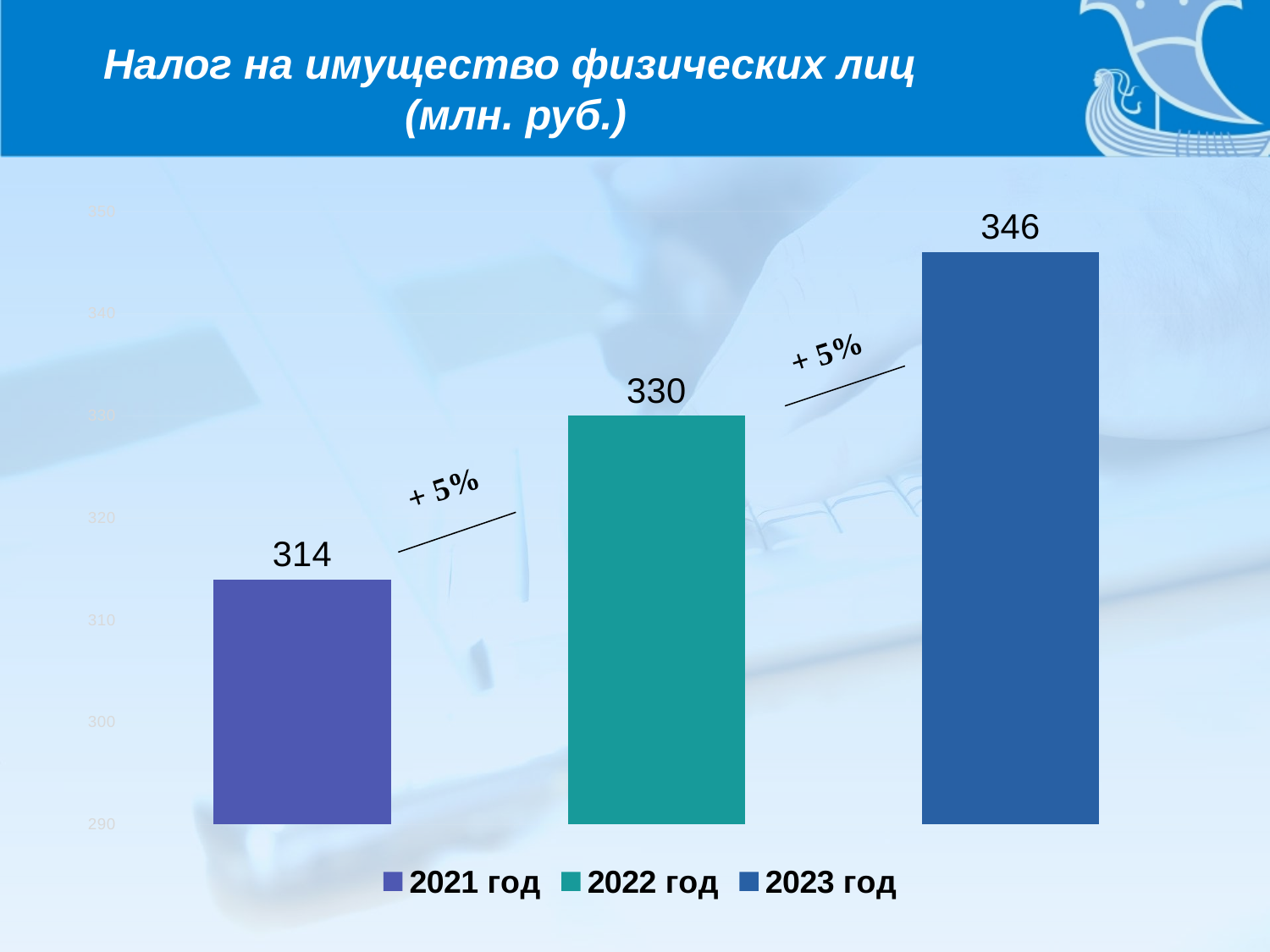
Which year has the lowest value? 2021 год Which is larger, the value for 2022 год or the value for 2023 год? 2023 год How many bars are shown in the chart? 3 What is the difference between the values for 2023 год and 2021 год? 32 How many entries does the legend list? 3 What is the difference between the values for 2022 год and 2021 год? 16 What is the value for 2022 год? 330 What kind of chart is shown on the slide? Bar chart Which year has the highest value? 2023 год What is the value for 2023 год? 346 What is the value for 2021 год? 314 Do the values rise or fall from 2021 год to 2023 год? Rise